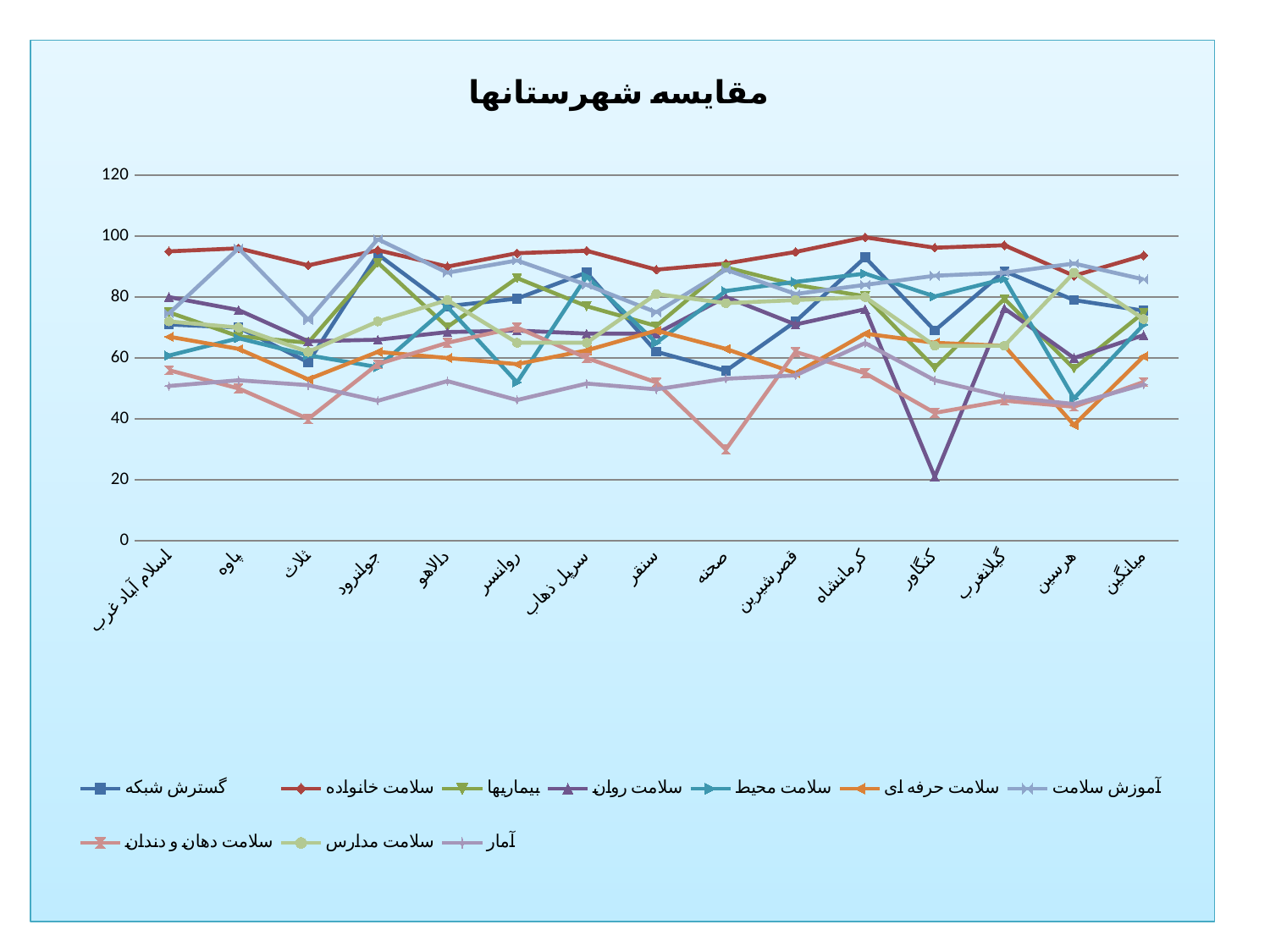
For کنگاور, which is larger: the value of سلامت خانواده or the value of سلامت روان? سلامت خانواده How many series does the legend list? 10 Is the value of سلامت دهان و دندان for صحنه greater or less than 40? less What is the title of the chart? مقایسه شهرستانها Is the value of سلامت خانواده for ثلاث greater or less than 80? greater How many categories are shown along the x axis? 15 Is the value of سلامت روان for کنگاور greater or less than 40? less Which series has the highest value for ثلاث? سلامت خانواده Which series has the lowest value for کنگاور? سلامت روان What is the highest value shown on the y axis? 120 What kind of chart is shown on the slide? line chart